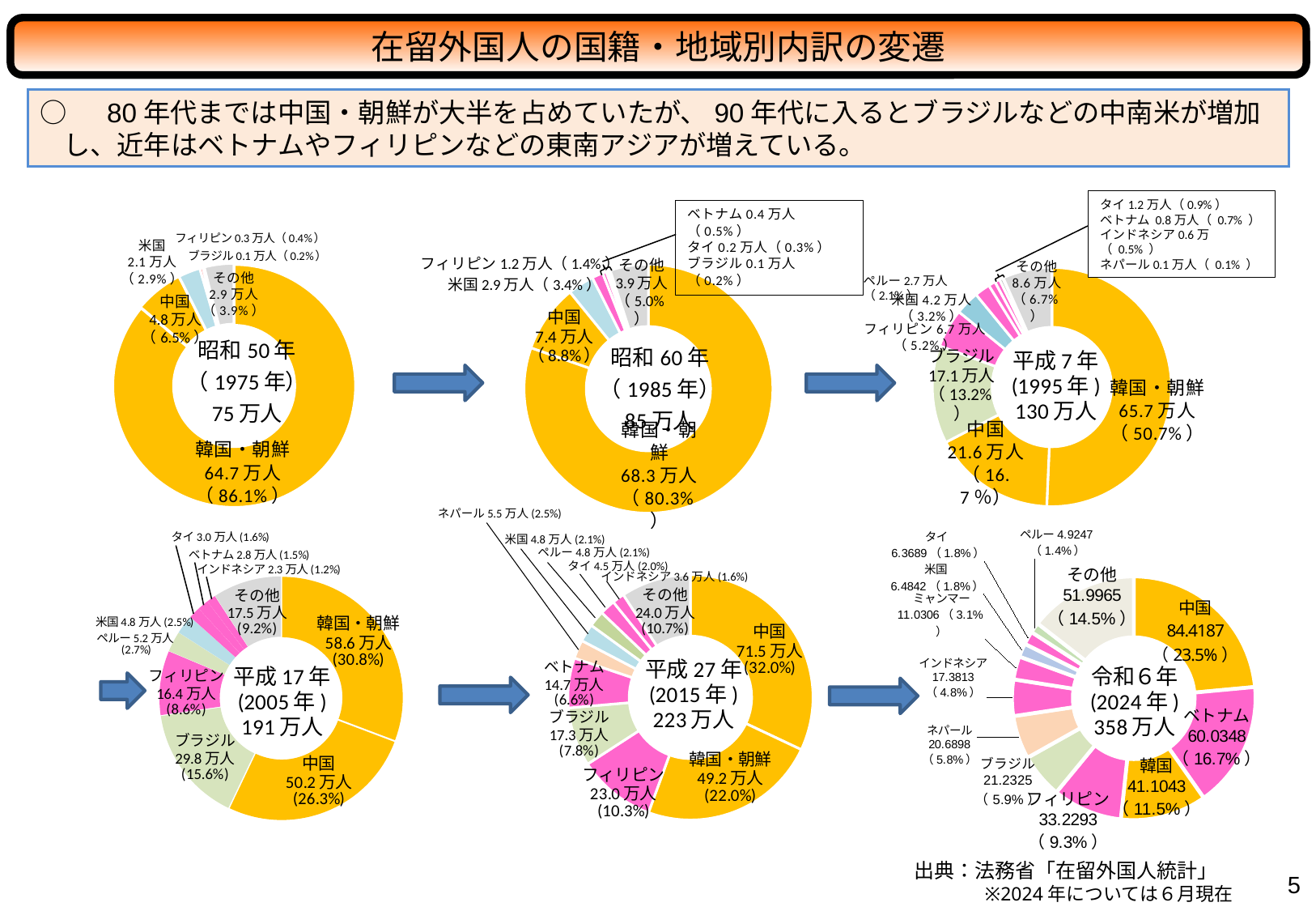
In the 平成17年 (2005年) chart, what is the difference in 万人 between 韓国・朝鮮 and 中国? 8.4万人 In the 令和6年 (2024年) chart, which named nationality has the smallest share? ペルー What total number of foreign residents is shown in the centre of the 平成27年 (2015年) chart? 223万人 What kind of chart is used for each year on this slide? Donut (pie) chart In the 昭和50年 (1975年) chart, what is the value shown for 韓国・朝鮮? 64.7万人 (86.1%) In the 昭和60年 (1985年) chart, what share does 中国 hold? 8.8% In the 平成17年 (2005年) chart, which nationality has the largest share? 韓国・朝鮮 In the 平成27年 (2015年) chart, which is larger, フィリピン or ブラジル? フィリピン In the 平成27年 (2015年) chart, what is the value shown for ベトナム? 14.7万人 (6.6%) How many donut charts are shown on the slide? 6 In the 平成7年 (1995年) chart, what is the value shown for ブラジル? 17.1万人 (13.2%) In the 令和6年 (2024年) chart, what share does ベトナム hold? 16.7%